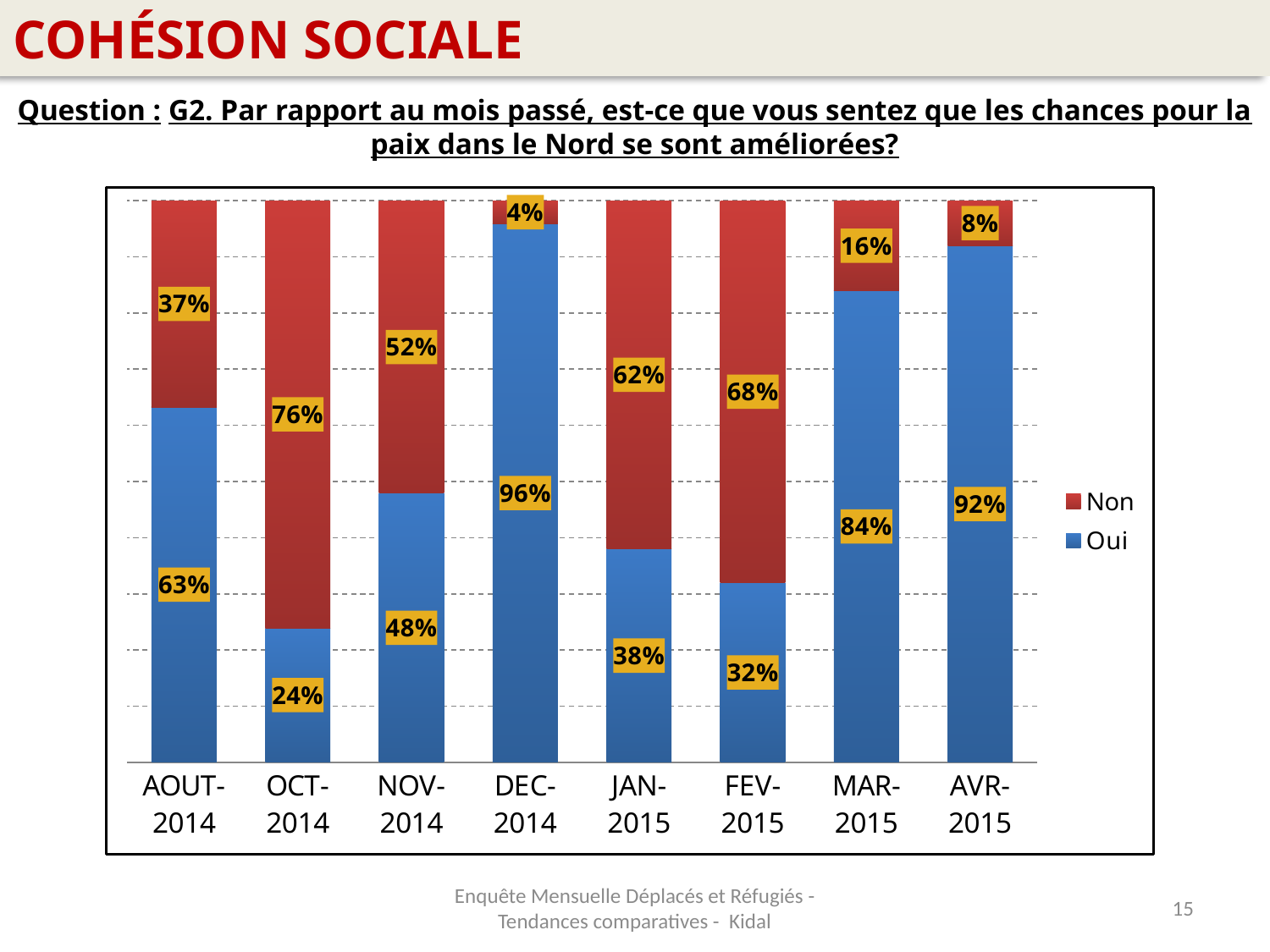
What is the value for Non in OCT-2014? 76% What kind of chart is shown on the slide? Stacked bar chart Which month has the highest value for Non? OCT-2014 Which is larger: the Oui value in AOUT-2014 or the Oui value in NOV-2014? AOUT-2014 How many series does the legend list? 2 Which month has the highest value for Oui? DEC-2014 What is the value for Oui in MAR-2015? 84% What is the difference between the Non value in FEV-2015 and the Non value in JAN-2015? 6% Which month has the lowest value for Oui? OCT-2014 What is the value for Oui in DEC-2014? 96% What is the value for Non in AVR-2015? 8% How many months are shown on the x axis? 8